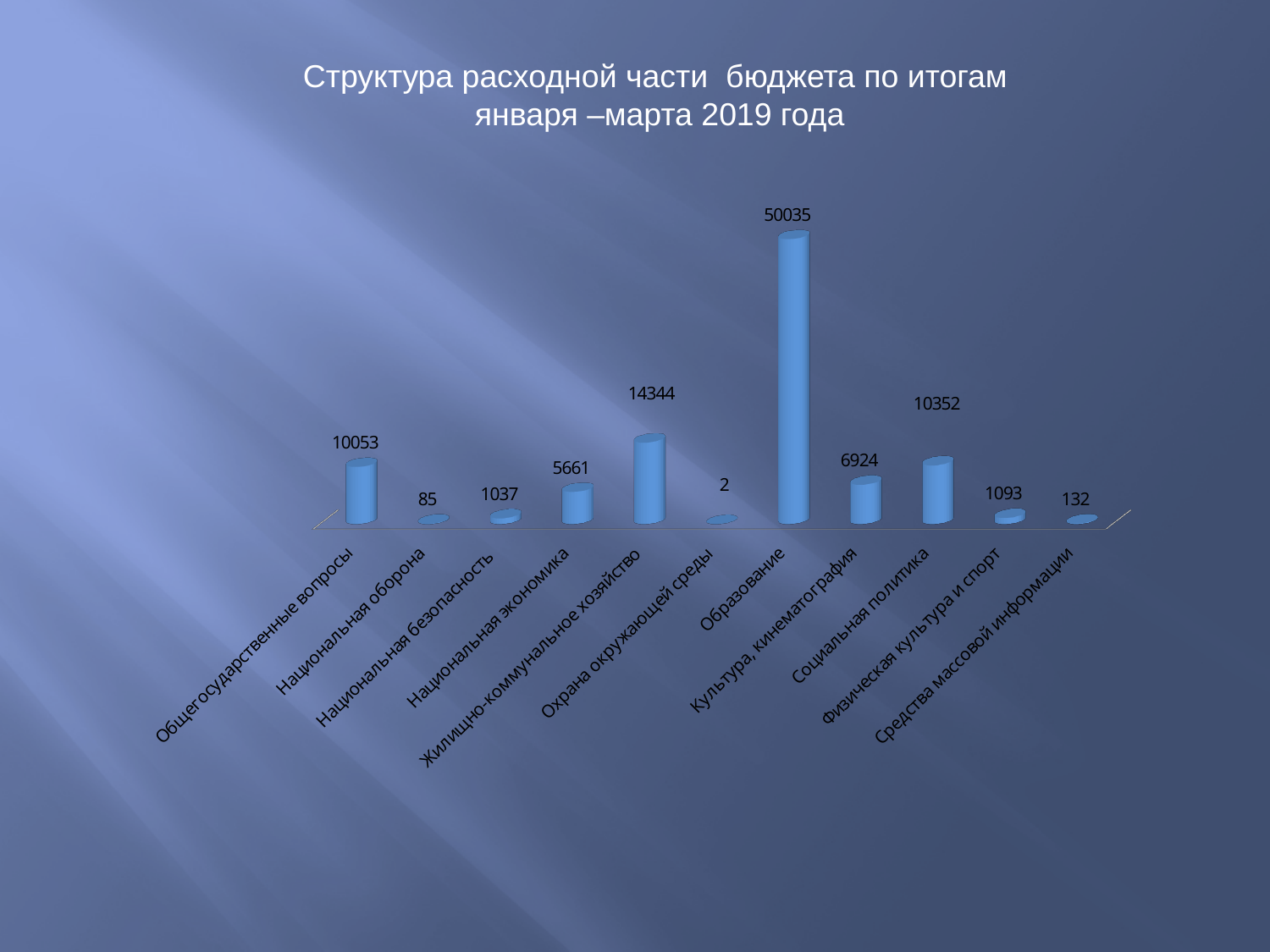
What kind of chart is shown on the slide? Bar chart What is the title of the chart? Структура расходной части бюджета по итогам января –марта 2019 года What is the value for Жилищно-коммунальное хозяйство? 14344 How many categories are shown in the chart? 11 What is the difference between the values for Образование and Жилищно-коммунальное хозяйство? 35691 Which is larger, the value for Национальная экономика or the value for Культура, кинематография? Культура, кинематография What is the value for Образование? 50035 Which category has the lowest value? Охрана окружающей среды What is the value for Социальная политика? 10352 What is the difference between the values for Социальная политика and Общегосударственные вопросы? 299 What is the value for Национальная оборона? 85 Which category has the highest value? Образование